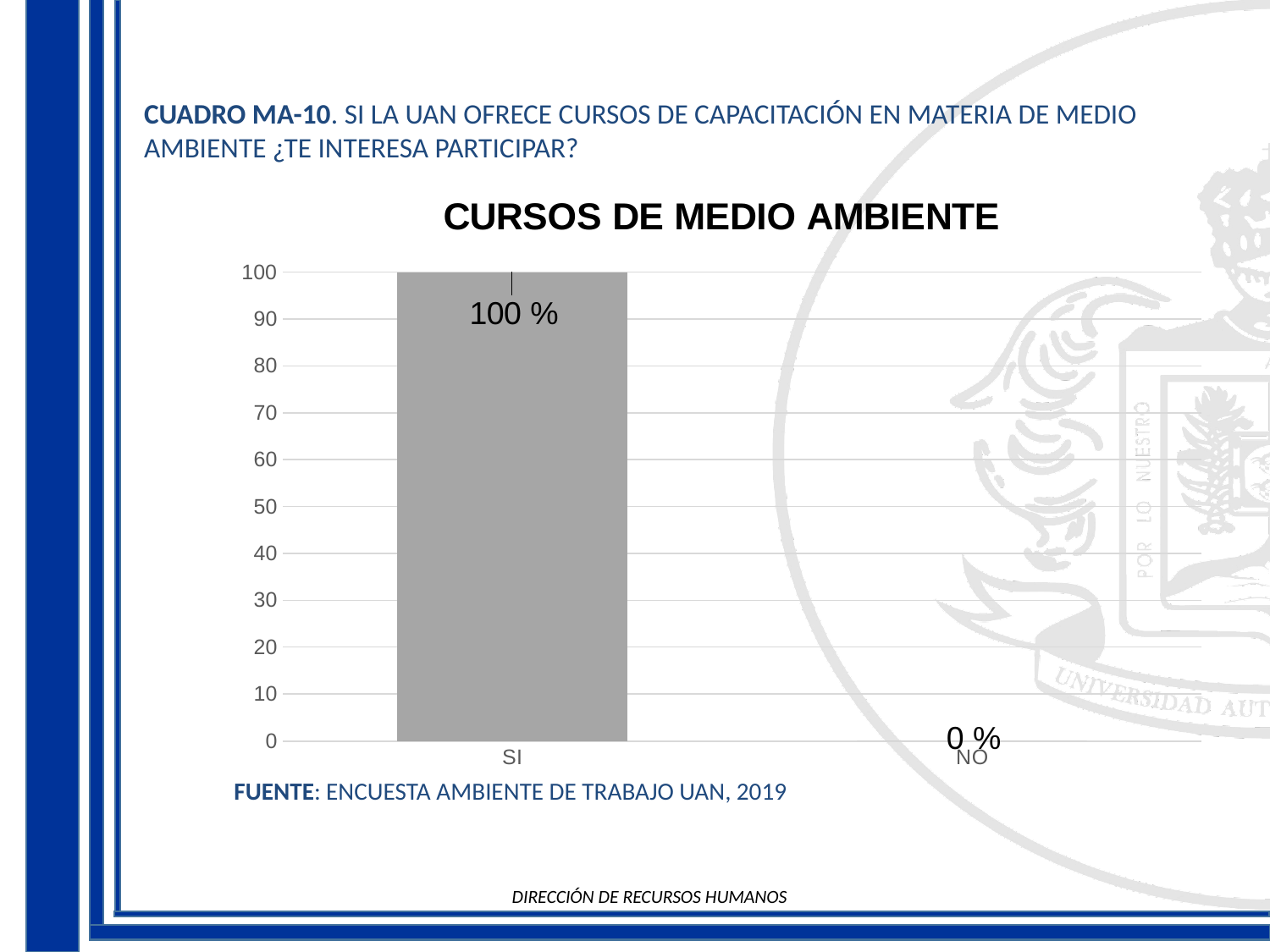
Which category has the lowest value? NO Which category has the highest value? SI What is the difference between the values for SI and NO? 100 % What is the title of the chart? CURSOS DE MEDIO AMBIENTE What kind of chart is shown on the slide? bar chart Do the values rise or fall from SI to NO along the x axis? fall How many categories are shown on the x axis of the chart? 2 Is the value for SI greater or less than 50? greater What is the value for NO in the chart? 0 % Which is larger, the value for SI or the value for NO? SI What is the highest value shown on the y axis of the chart? 100 What is the value for SI in the chart? 100 %